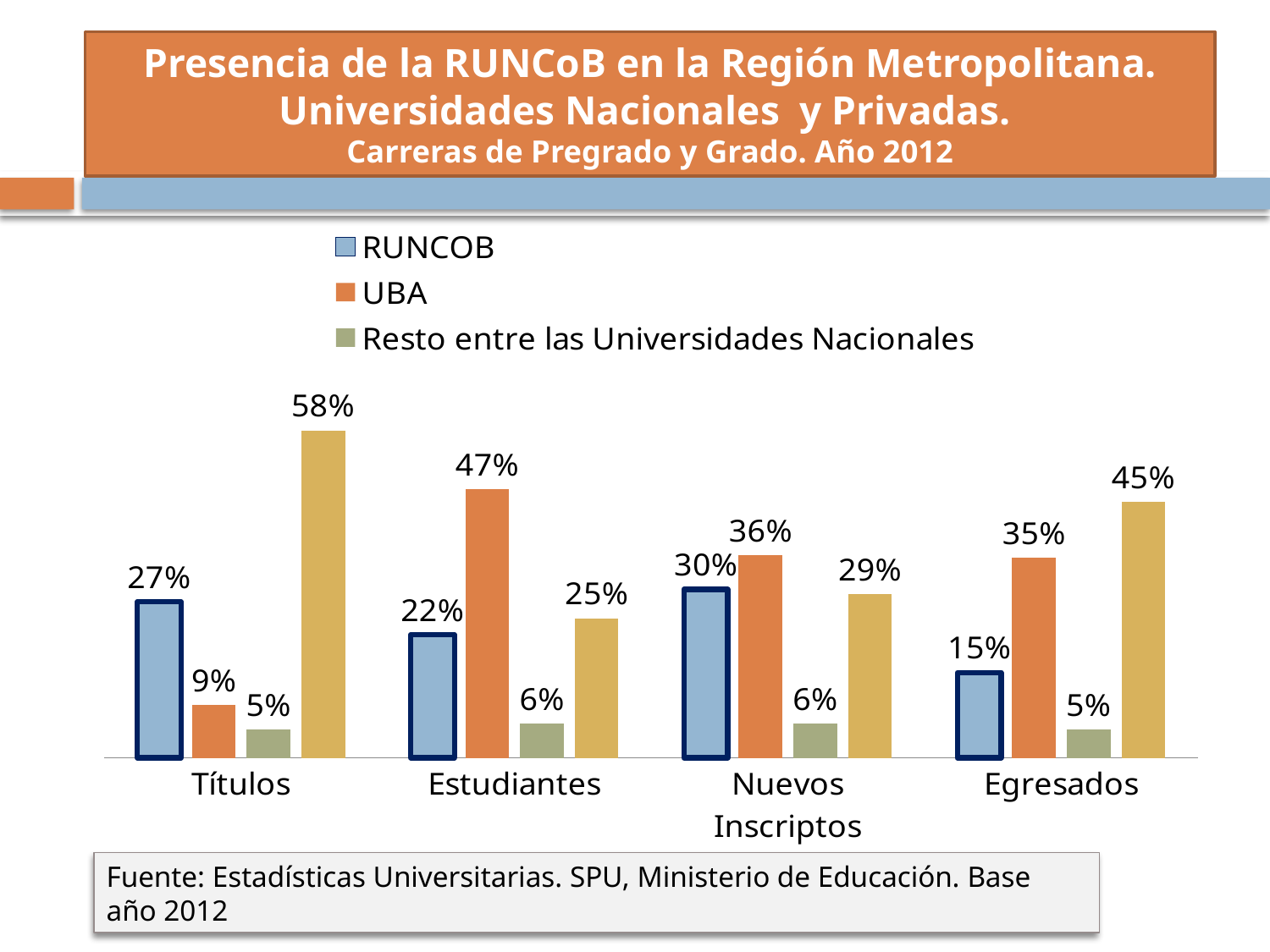
What is the RUNCOB value for Títulos? 27% What is the value for Resto entre las Universidades Nacionales in Nuevos Inscriptos? 6% In which category does UBA have its lowest value? Títulos In which category does RUNCOB have its highest value? Nuevos Inscriptos How many series does the legend list? 3 For Títulos, which is larger: the RUNCOB value or the UBA value? RUNCOB Which colour represents UBA in the legend? Orange What kind of chart is shown on the slide? Bar chart What is the difference between the UBA and RUNCOB values for Egresados? 20% How many categories are shown on the x axis? 4 What is the UBA value for Estudiantes? 47% What is the RUNCOB value for Egresados? 15%